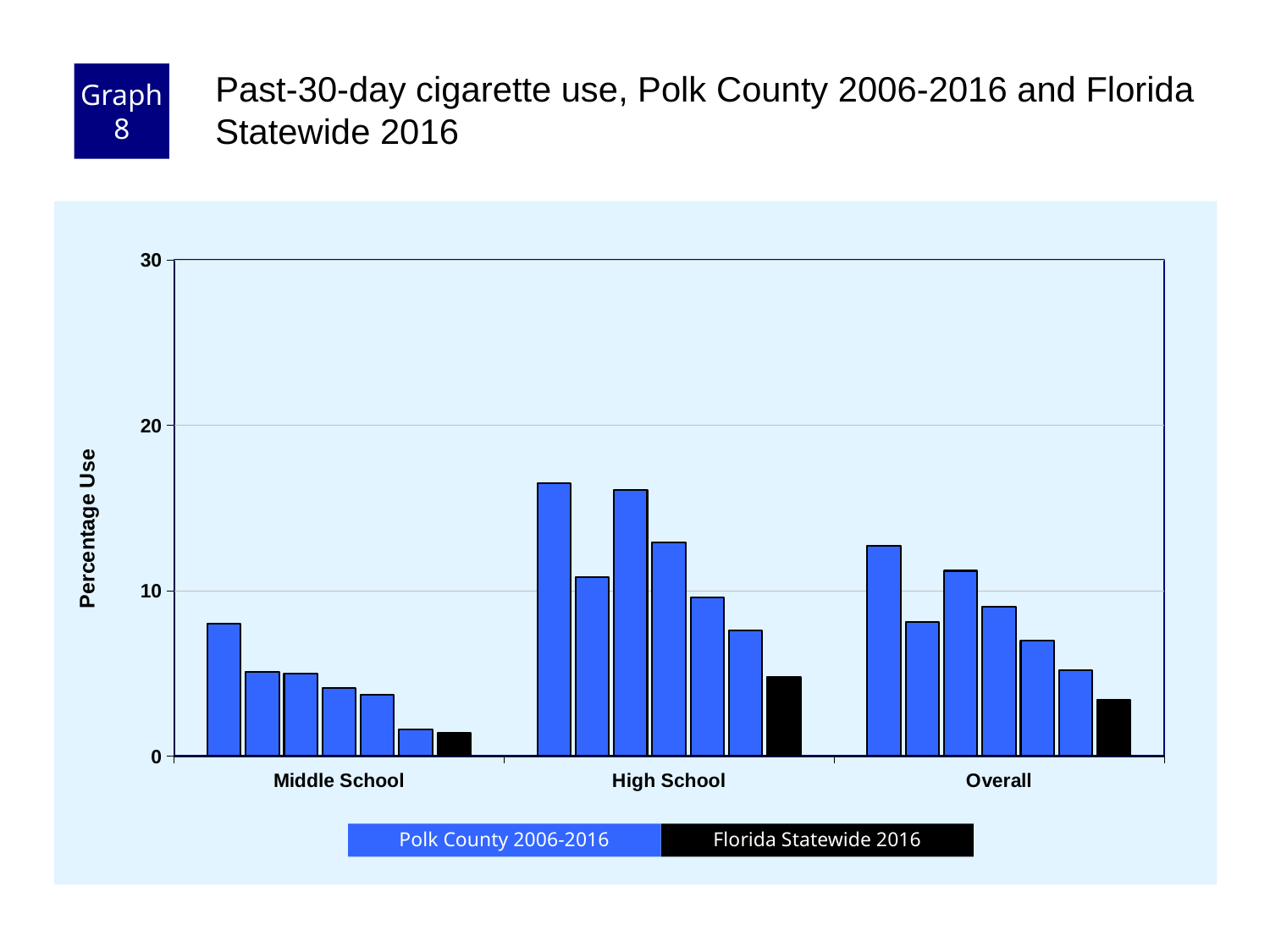
What kind of chart is shown on the slide? bar chart Which category has the tallest bars? High School Is the Florida Statewide 2016 value for High School greater or less than 10? less How many series does the legend list? 2 Within the Middle School group, do the Polk County 2006-2016 bars generally rise or fall from left to right? fall What is the label on the y axis? Percentage Use Which is larger, the Florida Statewide 2016 bar for High School or the Florida Statewide 2016 bar for Middle School? High School Is the tallest Polk County 2006-2016 bar for High School greater or less than 10? greater How many categories are shown on the x axis? 3 Which colour represents Florida Statewide 2016 in the legend? black Which category has the lowest bars overall? Middle School Is the tallest Polk County 2006-2016 bar for Middle School greater or less than 10? less